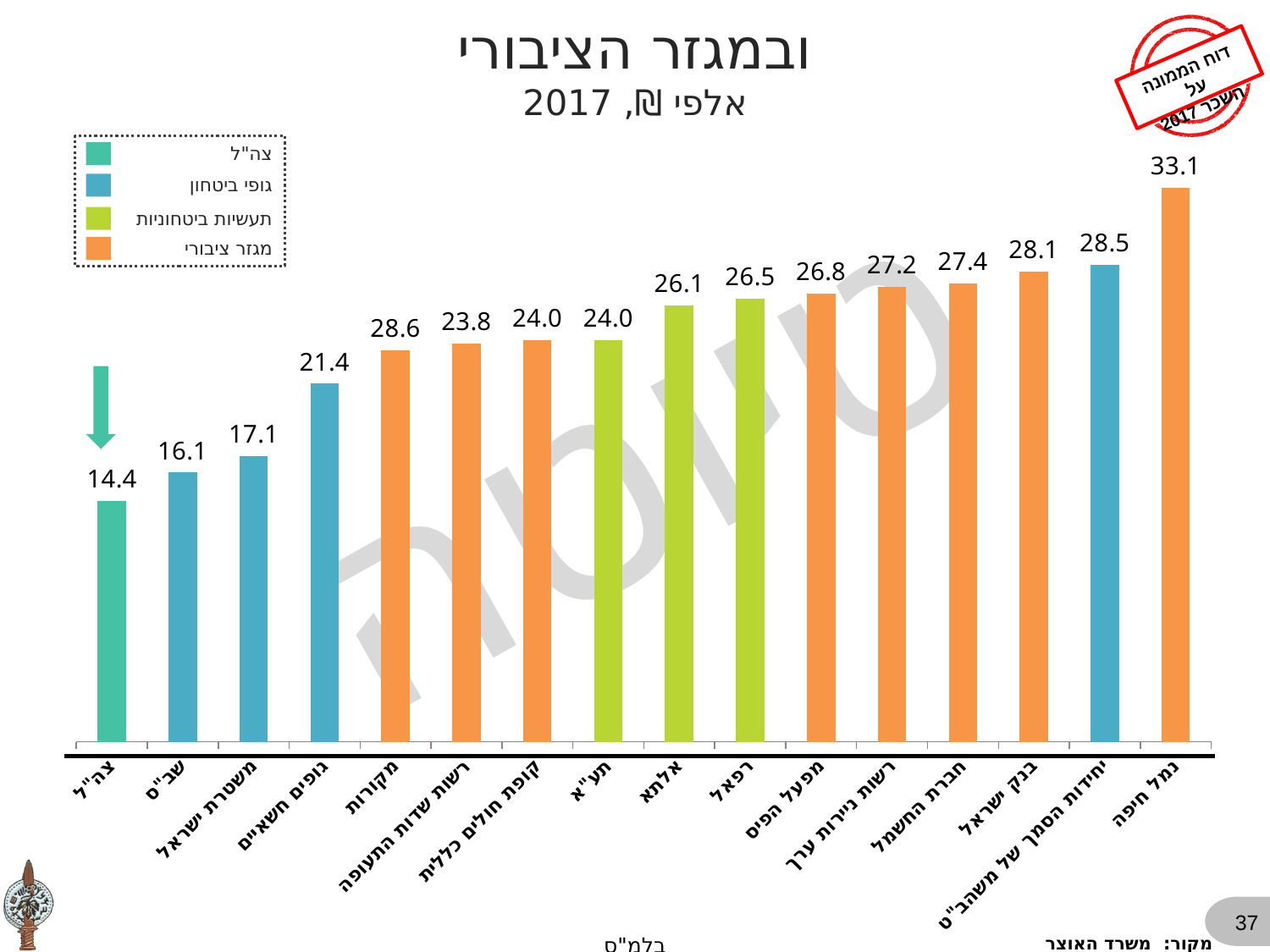
What is the value for נמל חיפה? 33.1 What is the value for צה"ל? 14.4 Which is larger, the value for חברת החשמל or the value for משטרת ישראל? חברת החשמל Which category has the highest value? נמל חיפה What is the difference between the values for נמל חיפה and צה"ל? 18.7 What year is shown in the chart subtitle? 2017 How many entries does the legend list? 4 How many categories are shown on the x axis? 16 What type of chart is shown on the slide? bar chart What is the value for רפאל? 26.5 What is the value for בנק ישראל? 28.1 Which category has the lowest value? צה"ל